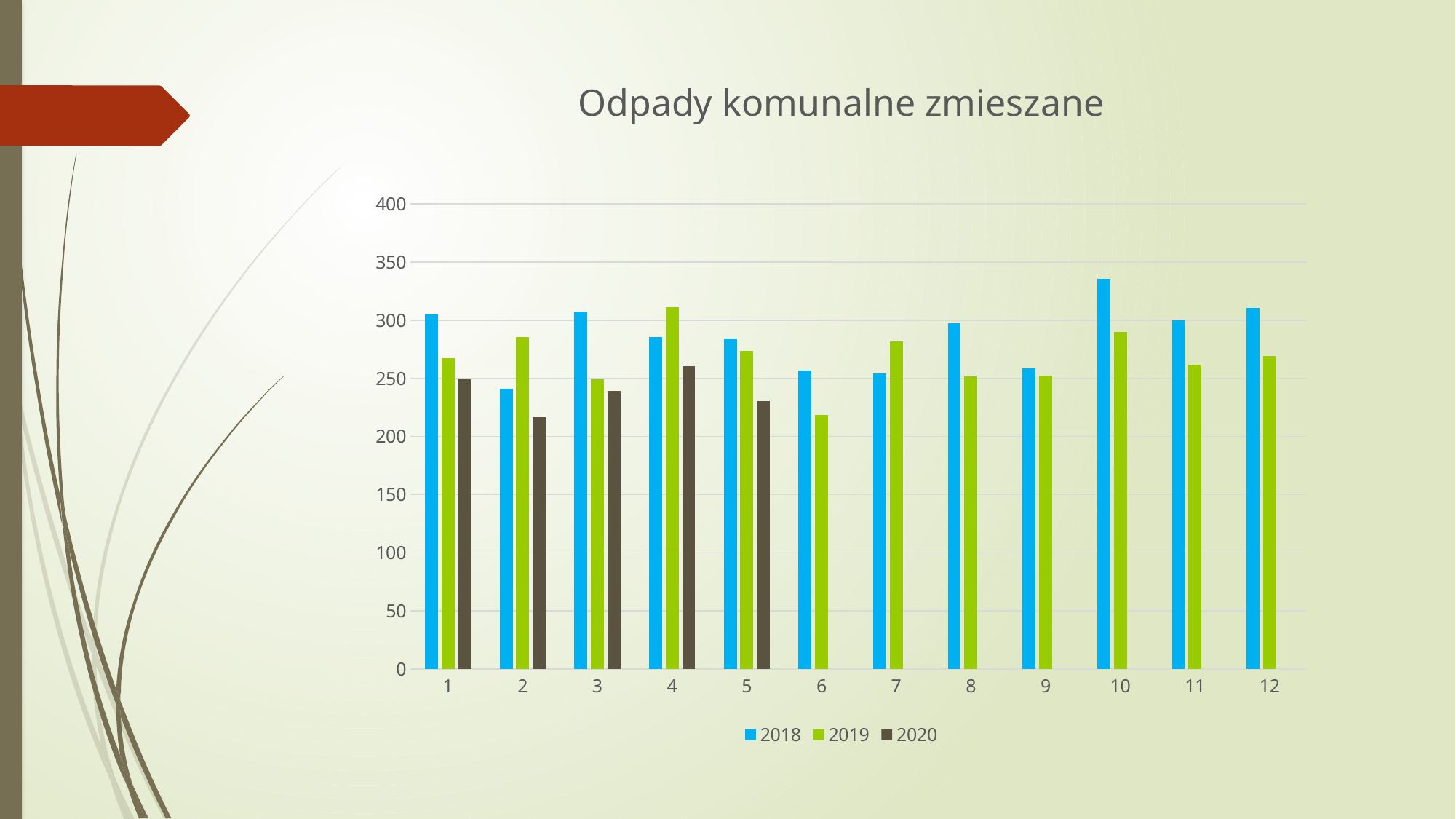
Which category has the lowest value for the 2020 series? 2 Which category has the lowest value for the 2018 series? 2 What is the title of the chart? Odpady komunalne zmieszane Which category has the highest value for the 2018 series? 10 In category 2, which series has the larger value, 2018 or 2019? 2019 Which category has the highest value for the 2019 series? 4 What kind of chart is shown on the slide? bar chart Which category has the lowest value for the 2019 series? 6 For how many categories is a 2020 bar plotted? 5 How many series does the legend list? 3 Is the 2018 value for category 10 greater or less than 300? greater How many categories are shown on the x axis? 12